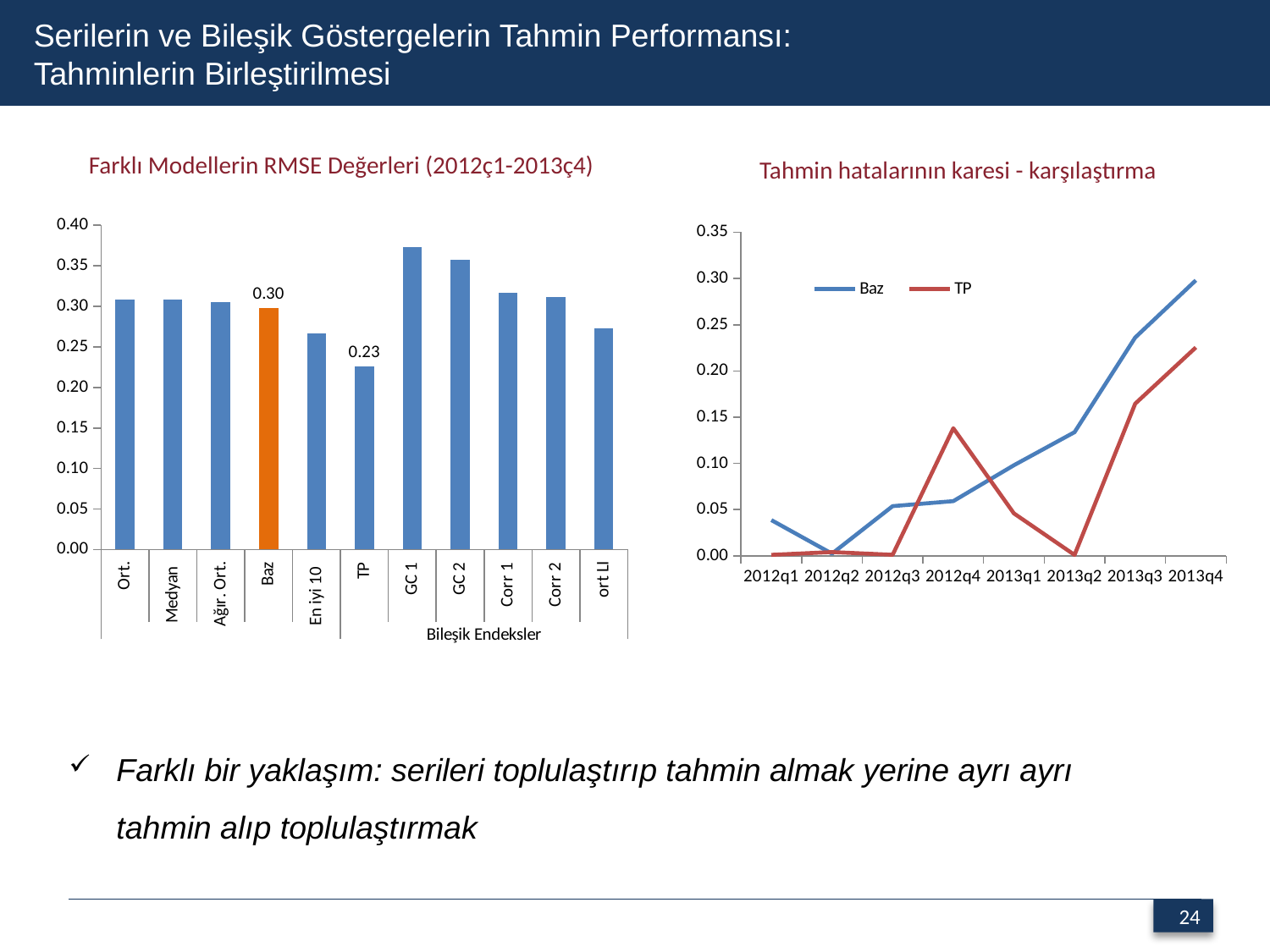
What kind of chart is 'Tahmin hatalarının karesi - karşılaştırma'? Line chart In the line chart 'Tahmin hatalarının karesi - karşılaştırma', how many series does the legend list? 2 In the bar chart 'Farklı Modellerin RMSE Değerleri', which model has the highest RMSE? GC 1 In the bar chart 'Farklı Modellerin RMSE Değerleri', which bar is coloured orange? Baz In the line chart 'Tahmin hatalarının karesi - karşılaştırma', at 2012q4 which series has the larger value, Baz or TP? TP In the bar chart 'Farklı Modellerin RMSE Değerleri', is the value for GC 1 greater or less than 0.35? greater In the bar chart 'Farklı Modellerin RMSE Değerleri', what is the RMSE value for Baz? 0.30 In the bar chart 'Farklı Modellerin RMSE Değerleri', which model has the lowest RMSE? TP In the bar chart 'Farklı Modellerin RMSE Değerleri', what is the difference between the values for Baz and TP? 0.07 In the bar chart 'Farklı Modellerin RMSE Değerleri', what is the RMSE value for TP? 0.23 In the bar chart 'Farklı Modellerin RMSE Değerleri', how many models (bars) are shown? 11 In the line chart 'Tahmin hatalarının karesi - karşılaştırma', is the Baz value at 2013q4 greater or less than 0.25? greater